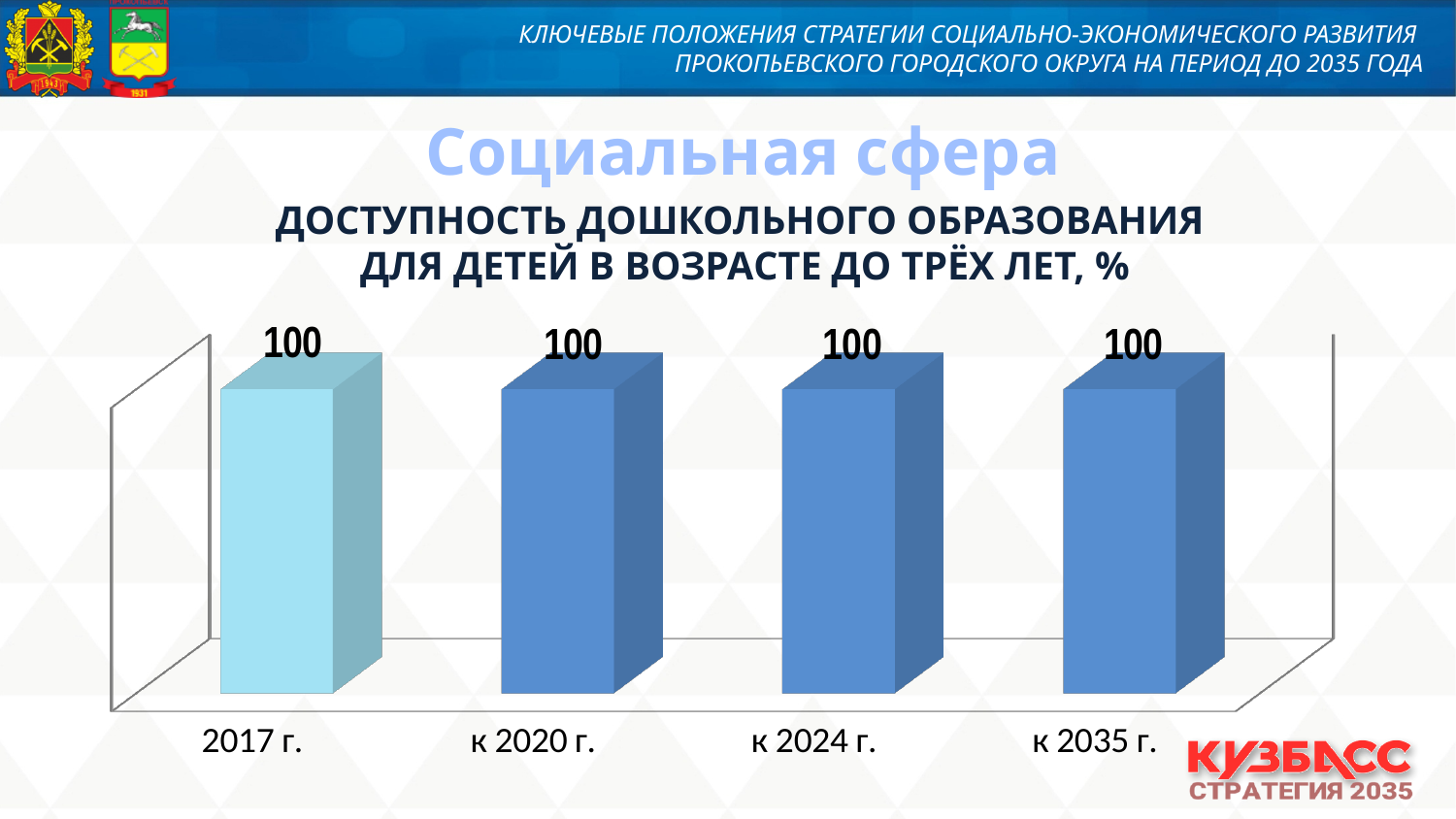
What is the value for к 2024 г.? 100 What kind of chart is shown on the slide? Bar chart What is the difference between the values for 2017 г. and к 2035 г.? 0 What is the title of the chart? ДОСТУПНОСТЬ ДОШКОЛЬНОГО ОБРАЗОВАНИЯ ДЛЯ ДЕТЕЙ В ВОЗРАСТЕ ДО ТРЁХ ЛЕТ, % What is the label of the first category on the x axis? 2017 г. What is the value for 2017 г.? 100 How many categories are shown on the x axis of the chart? 4 Do the values rise, fall or stay the same from 2017 г. to к 2035 г.? Stay the same What is the label of the last category on the x axis? к 2035 г. What is the value for к 2020 г.? 100 What is the value for к 2035 г.? 100 Which category's bar is shown in a lighter blue colour than the others? 2017 г.